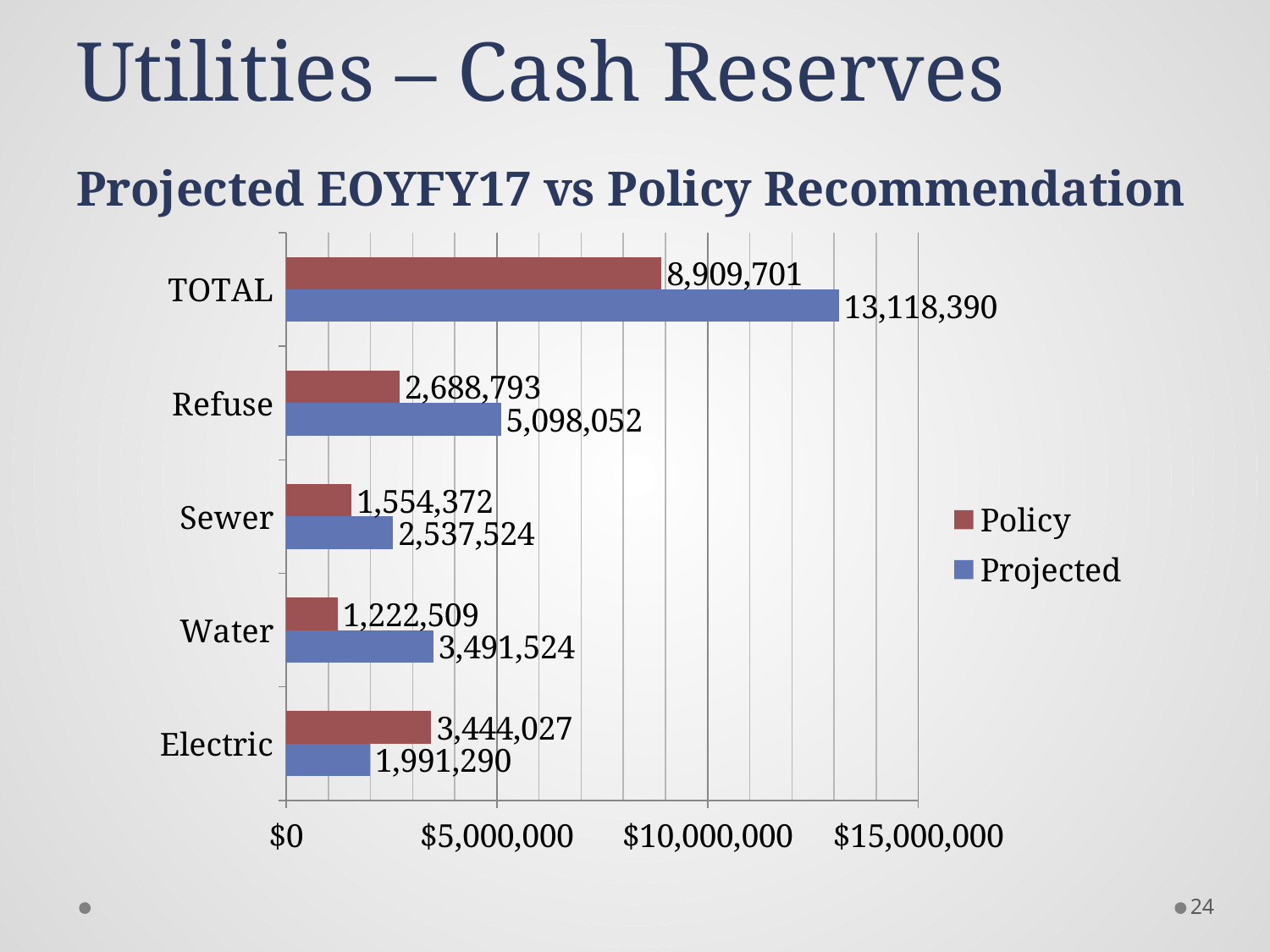
How many categories are shown on the chart? 5 What is the Projected value for Refuse? 5,098,052 What is the difference between the Policy and Projected values for Electric? 1,452,737 What is the Policy value for Water? 1,222,509 Excluding TOTAL, which category has the highest Projected value? Refuse How many series does the legend list? 2 What is the Projected value for TOTAL? 13,118,390 For Electric, which is larger: the Policy value or the Projected value? Policy What is the difference between the Projected and Policy values for TOTAL? 4,208,689 What is the Policy value for Electric? 3,444,027 What kind of chart is shown on the slide? Bar chart Excluding TOTAL, which category has the lowest Policy value? Water